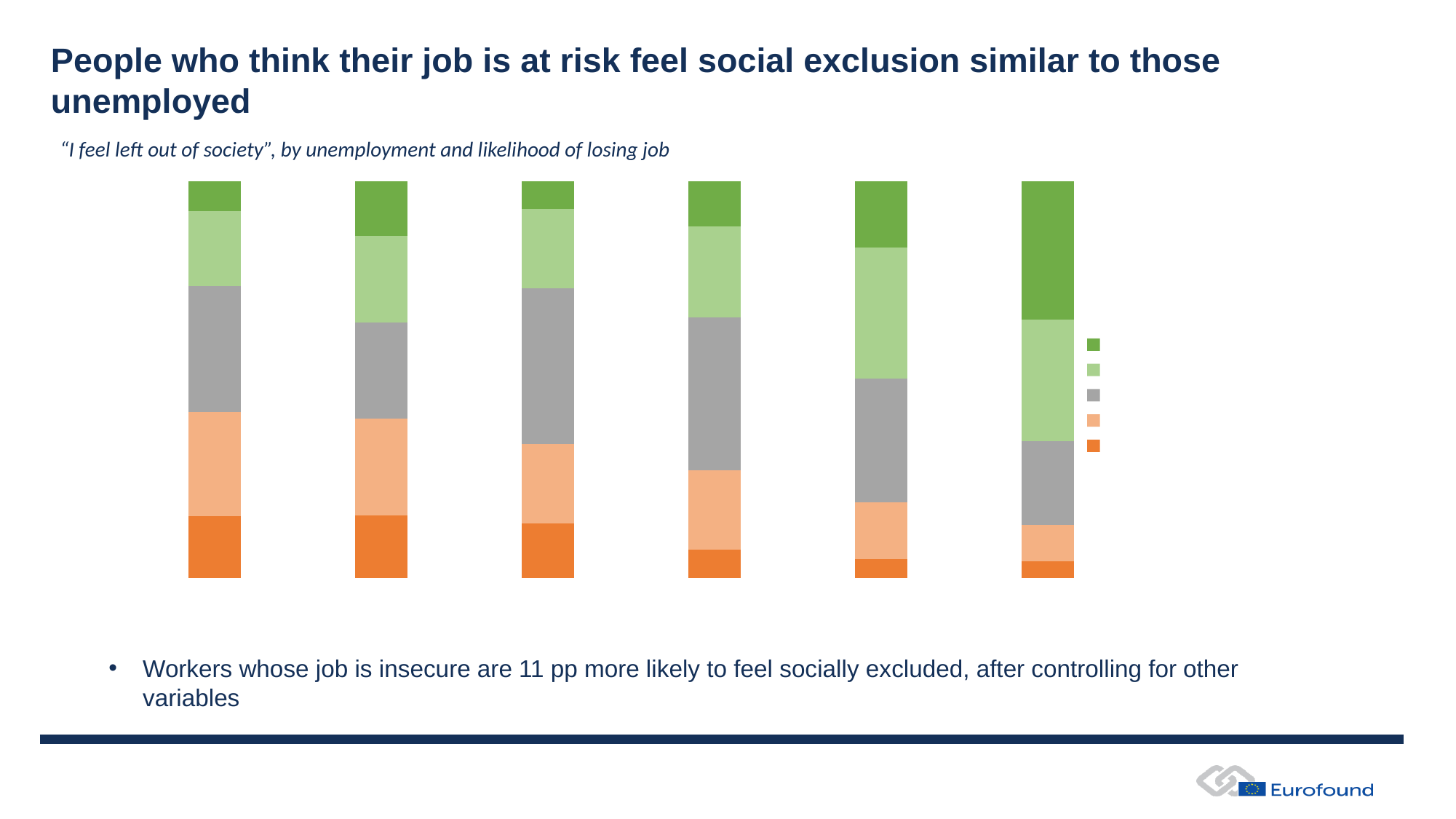
Which bar, counting from the left, has the largest dark green (top) segment? The sixth (rightmost) bar What colour is the bottom segment of each stacked bar? Orange Is the dark green segment larger in the first bar or in the sixth bar? The sixth bar Does the size of the dark green top segment increase or decrease moving from the leftmost bar to the rightmost bar? Increase How many bars are plotted in the chart? 6 What is the title of the chart? "I feel left out of society", by unemployment and likelihood of losing job How many series (colour entries) does the legend list? 5 What kind of chart is shown on the slide? Stacked bar chart Does the size of the orange bottom segment increase or decrease moving from the leftmost bar to the rightmost bar? Decrease